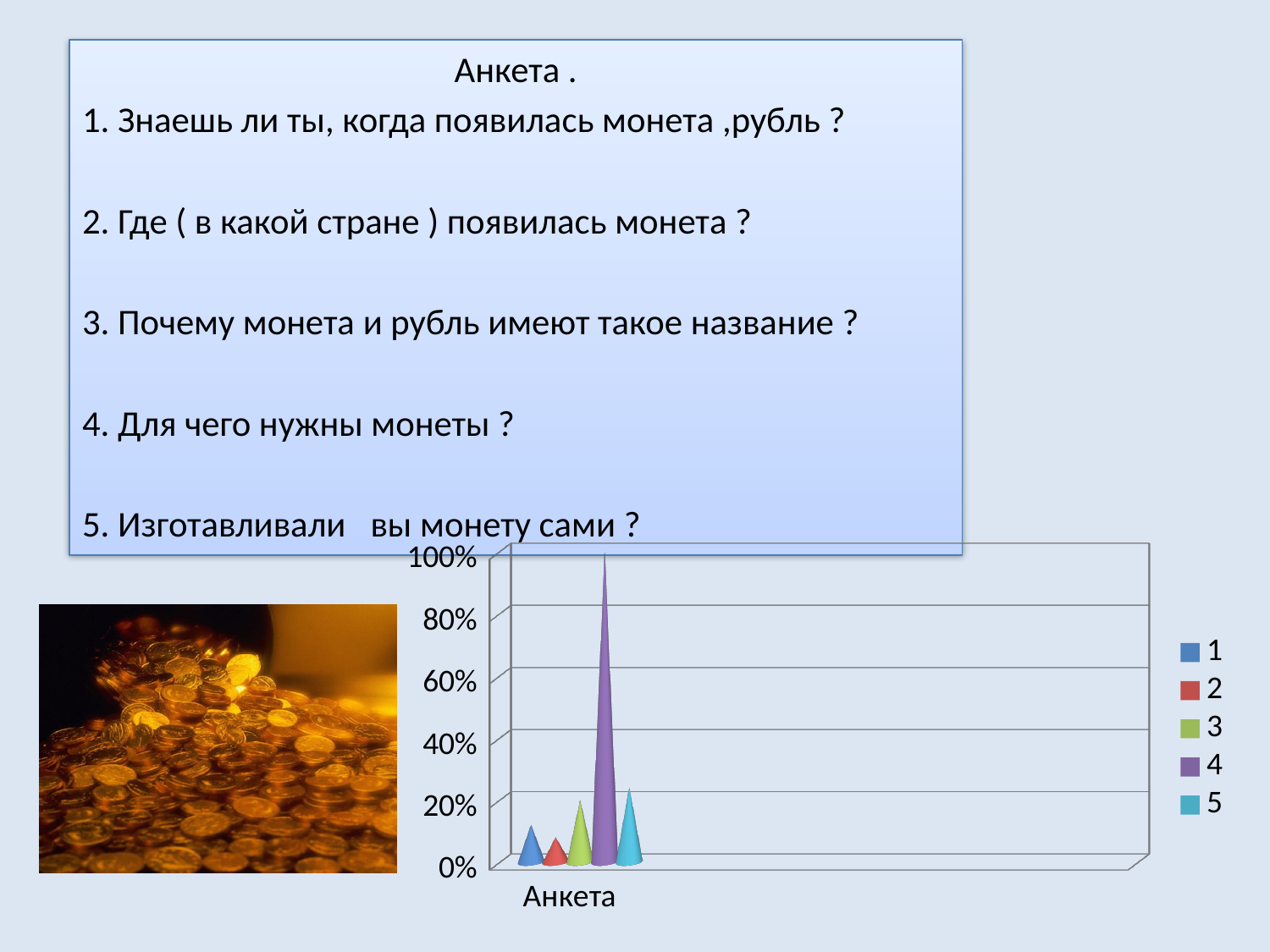
Is the value for series 4 greater or less than 80%? greater Which series has the highest value in the chart? 4 How many series does the chart legend list? 5 Which is larger, the value for series 4 or the value for series 1? 4 Which is larger, the value for series 5 or the value for series 2? 5 Is the value for series 2 greater or less than 20%? less How many categories are shown on the x axis of the chart? 1 Which series has the lowest value in the chart? 2 Is the value for series 5 greater or less than 40%? less What kind of chart is shown on the slide? bar chart What is the category label shown on the x axis of the chart? Анкета